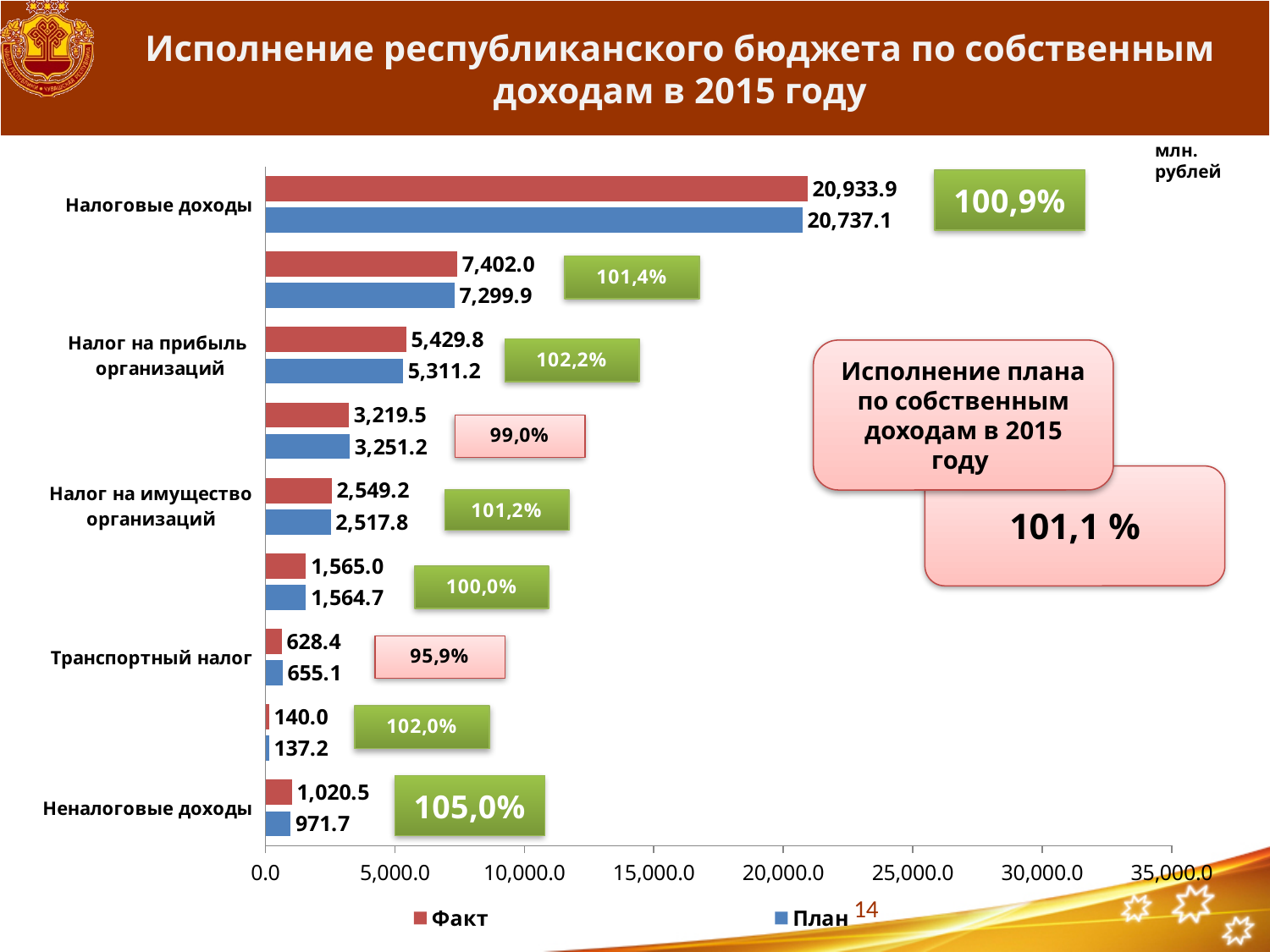
What is the План value for Налоговые доходы? 20,737.1 What is the difference between the План and Факт values for Транспортный налог? 26.7 How many series does the legend list? 2 What is the План value for Транспортный налог? 655.1 What is the Факт value for Налоговые доходы? 20,933.9 What is the Факт value for Неналоговые доходы? 1,020.5 For Налог на имущество организаций, which is larger: Факт or План? Факт Which category has the highest Факт value? Налоговые доходы What is the difference between the Факт and План values for Налоговые доходы? 196.8 What is the Факт value for Налог на прибыль организаций? 5,429.8 Is the Факт value for Налоговые доходы greater or less than 20,000.0? greater What kind of chart is shown on the slide? Bar chart